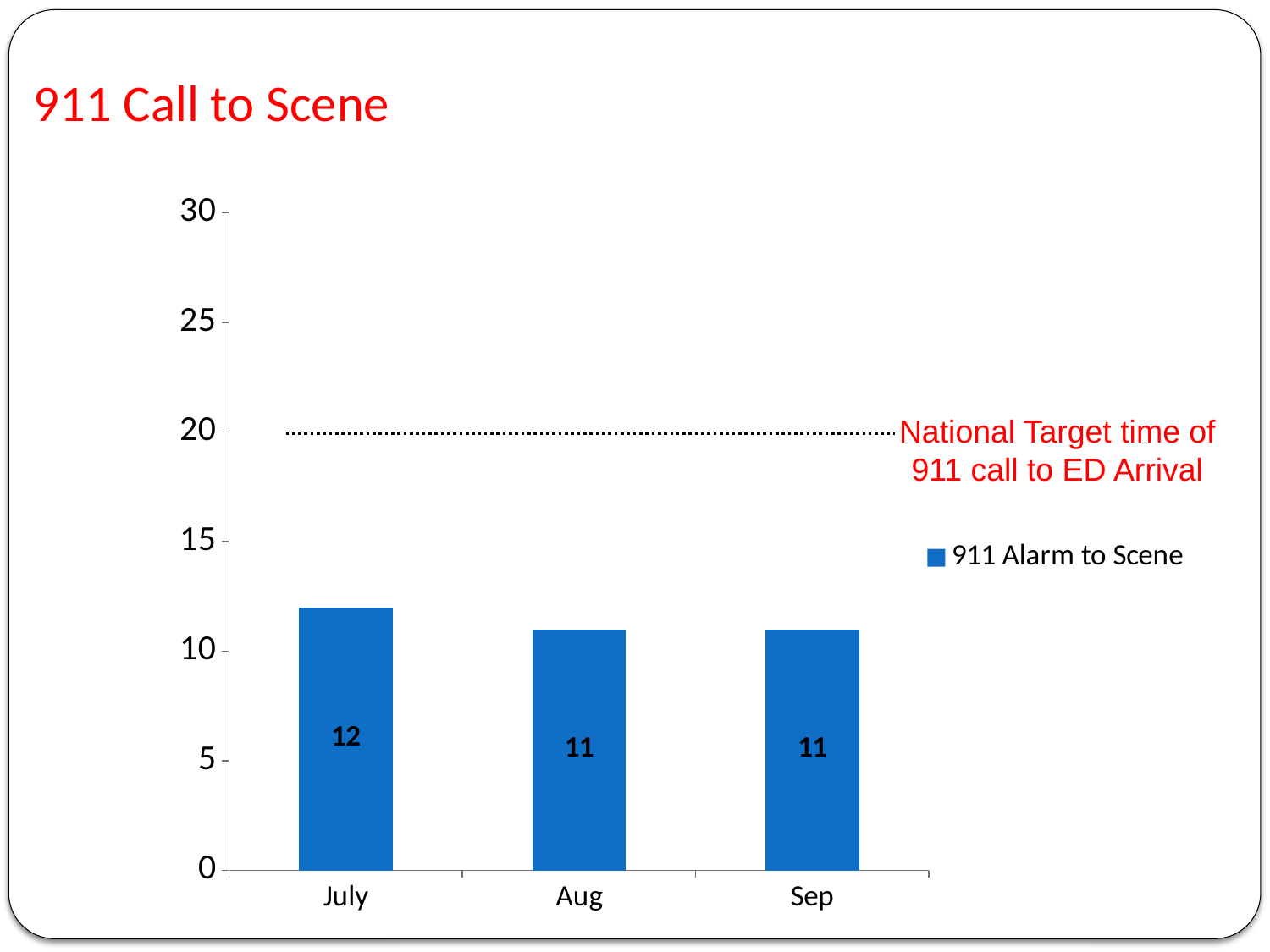
What is the value for July? 12 Which is larger, the value for July or the value for Sep? July How many series does the legend list? 1 What is the value for Aug? 11 Do the values rise or fall from July to Aug? fall Is the value for July greater or less than 20? less What is the value for Sep? 11 What is the legend entry for the blue bars? 911 Alarm to Scene How many months are shown on the x axis? 3 What is the difference between the values for July and Aug? 1 What kind of chart is shown? bar chart Which month has the highest value? July